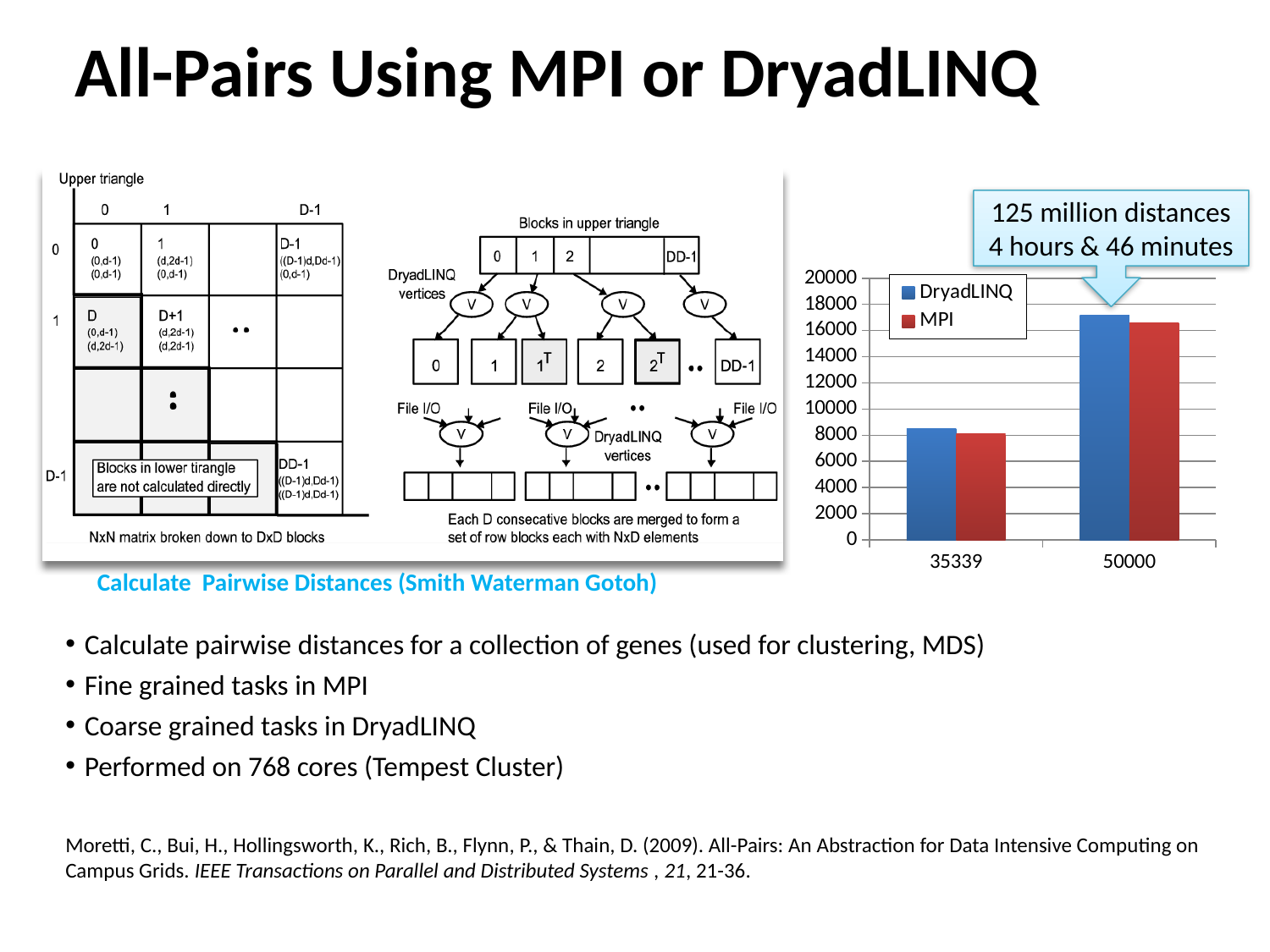
Which category on the x axis of the bar chart has the tallest bars? 50000 How many series does the legend of the bar chart list? 2 In the bar chart, is the DryadLINQ value for 35339 greater or less than 8000? greater What kind of chart is shown on the right of the slide? bar chart In the bar chart, is the MPI value for 50000 greater or less than 18000? less How many categories are shown on the x axis of the bar chart? 2 In the bar chart, is the MPI value for 35339 greater or less than 10000? less In the bar chart, for the 50000 category, which series has the larger value, DryadLINQ or MPI? DryadLINQ Which category on the x axis of the bar chart has the shortest bars? 35339 What are the two series named in the legend of the bar chart? DryadLINQ and MPI Do the values in the bar chart rise or fall from 35339 to 50000? rise